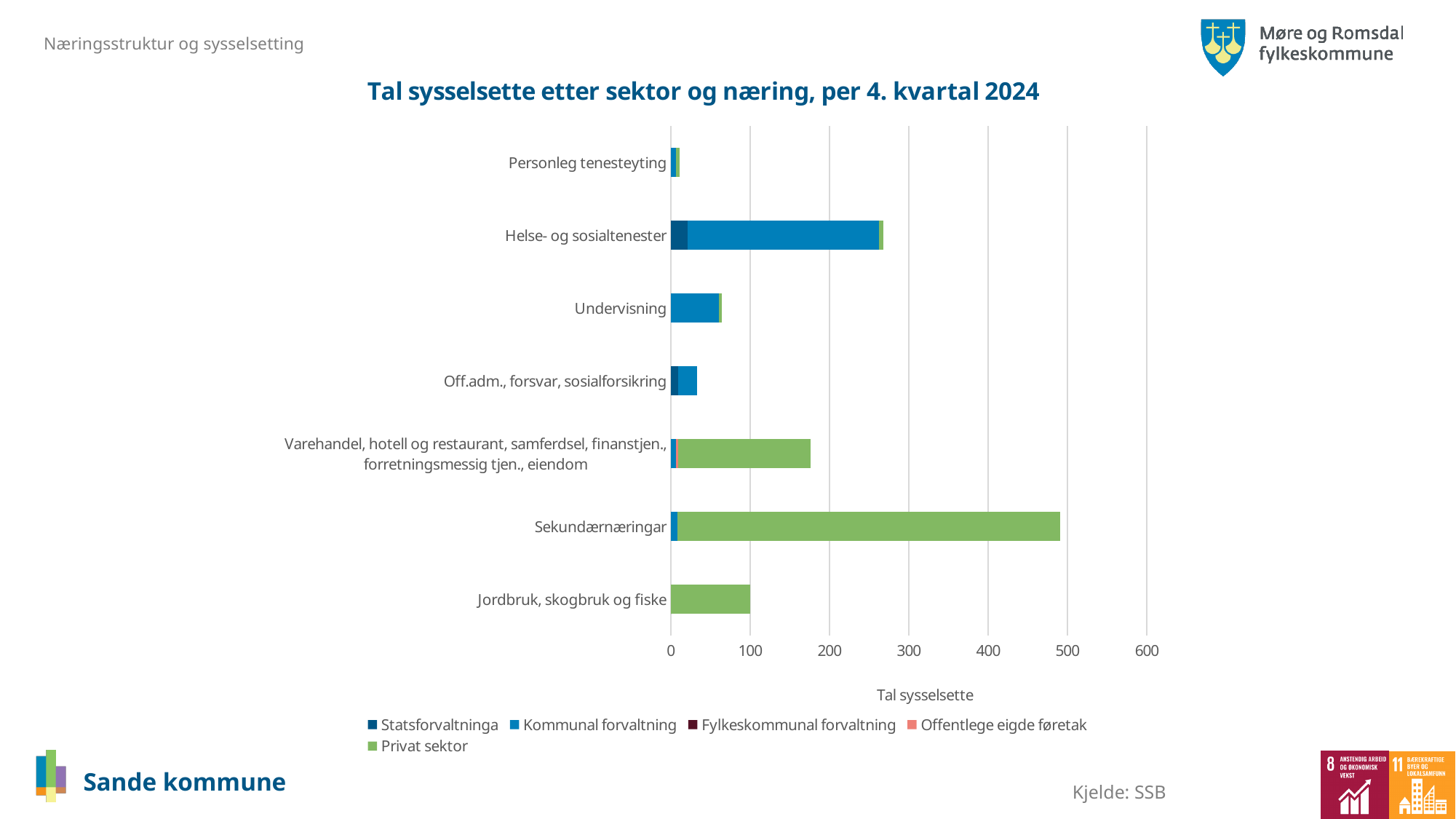
Which category has the lowest total number of employed? Personleg tenesteyting Is the total value for Helse- og sosialtenester greater or less than 200? greater What is the title of the chart? Tal sysselsette etter sektor og næring, per 4. kvartal 2024 What is the label on the horizontal axis? Tal sysselsette How many categories (næringar) are shown on the chart? 7 Which has a larger total: Helse- og sosialtenester or Varehandel, hotell og restaurant, samferdsel, finanstjen., forretningsmessig tjen., eiendom? Helse- og sosialtenester Which category has the highest total number of employed (tal sysselsette)? Sekundærnæringar Is the total value for Sekundærnæringar greater or less than 400? greater Which has a larger total: Undervisning or Off.adm., forsvar, sosialforsikring? Undervisning How many series does the legend list? 5 What kind of chart is shown on the slide? Bar chart Is the total value for Undervisning greater or less than 100? less